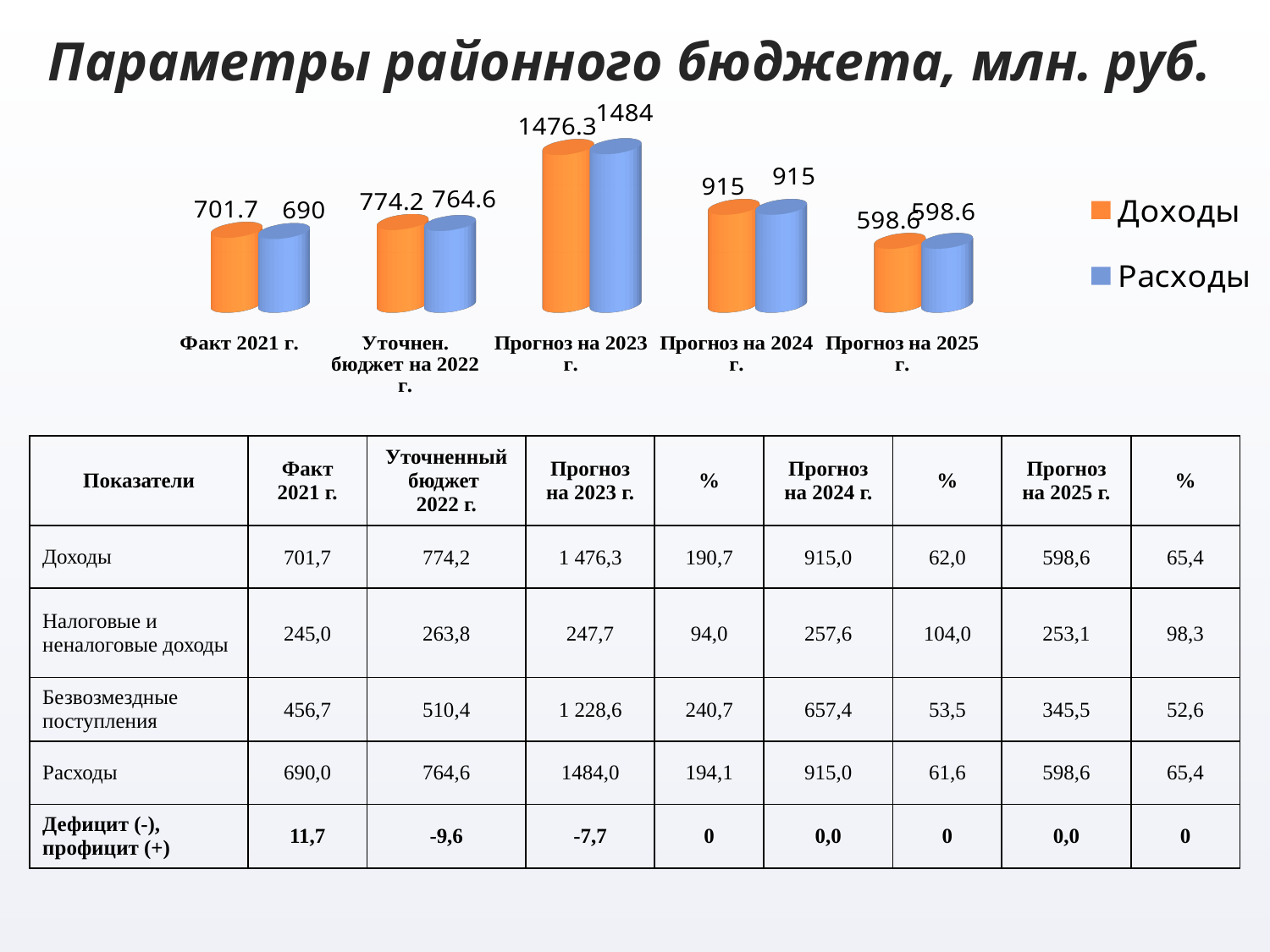
What is the value of Доходы for Факт 2021 г.? 701.7 What is the value of Расходы for Уточнен. бюджет на 2022 г.? 764.6 What is the value of Доходы for Прогноз на 2025 г.? 598.6 Which is larger for Прогноз на 2023 г., Доходы or Расходы? Расходы What is the value of Расходы for Прогноз на 2023 г.? 1484 How many categories are shown on the x axis of the chart? 5 How many series does the chart legend list? 2 Which series is shown in orange in the chart? Доходы What is the difference between Доходы and Расходы for Факт 2021 г.? 11.7 Which category has the highest value for Доходы? Прогноз на 2023 г. Which category has the lowest value for Расходы? Прогноз на 2025 г. What kind of chart is shown on the slide? Bar chart